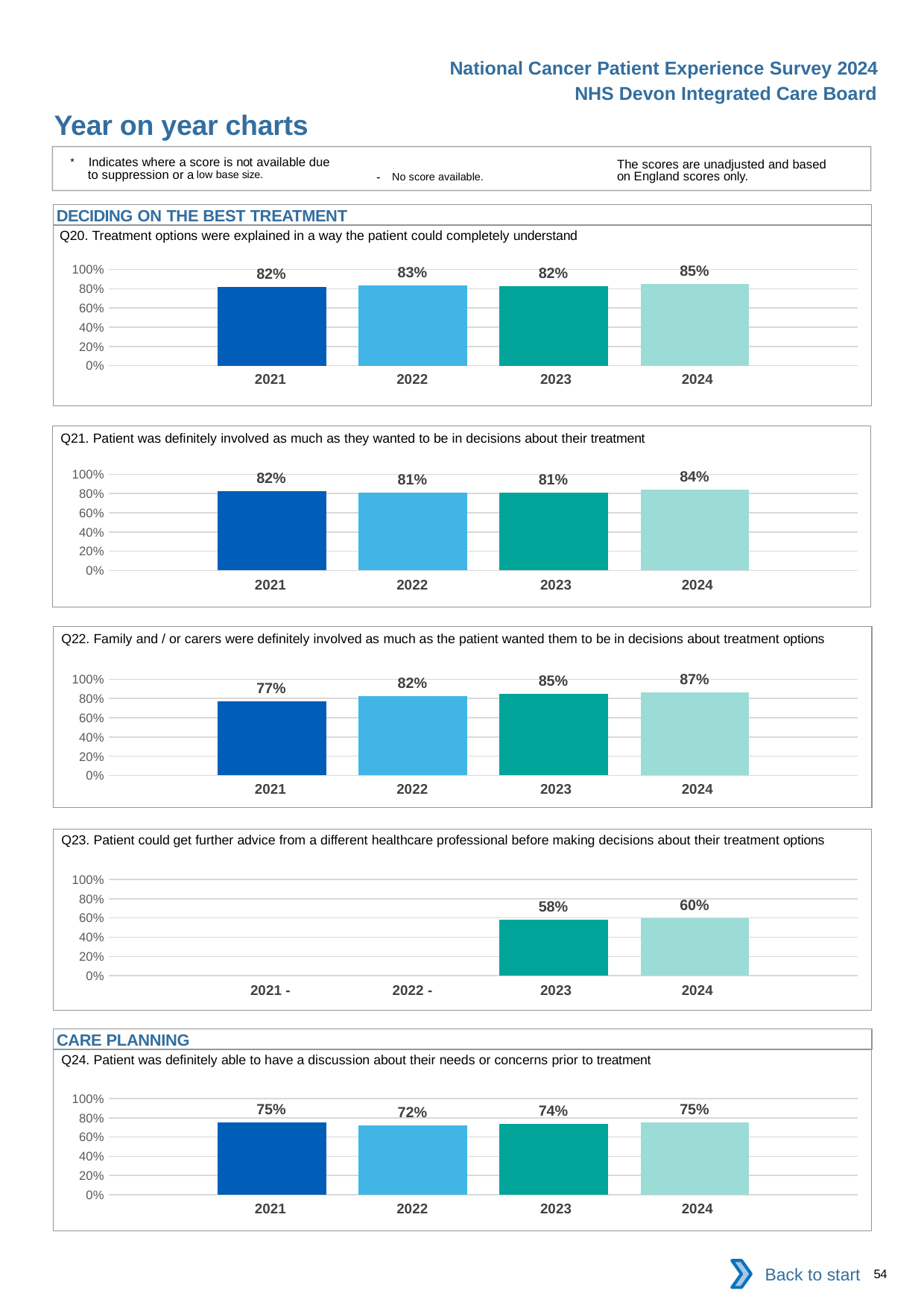
What kind of chart is the Q24 chart? bar chart In the Q23 chart, what is the value for 2023? 58% In the Q20 chart, what is the value for 2024? 85% In the Q22 chart, what is the difference between the 2024 and 2021 values? 10% In the Q24 chart, which year has the lowest value? 2022 In the Q22 chart, do the values rise or fall from 2021 to 2024? rise In the Q23 chart, how many years have a bar plotted? 2 In the Q24 chart, is the value for 2022 larger or smaller than the value for 2023? smaller In the Q22 chart, which year has the lowest value? 2021 In the Q21 chart, what is the difference between the 2024 and 2021 values? 2% In the Q21 chart, what is the value for 2022? 81% In the Q20 chart, which year has the highest value? 2024